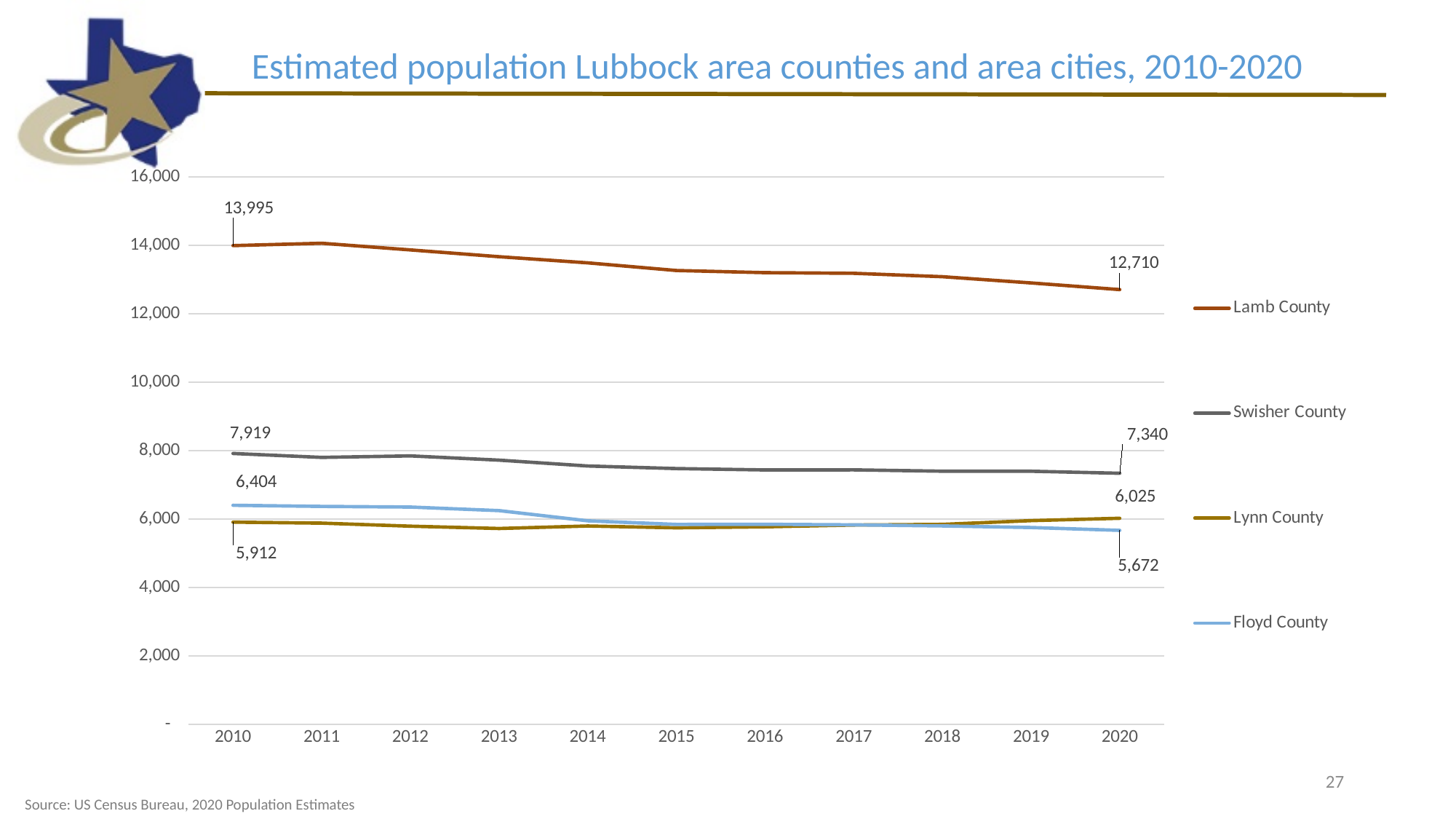
Did Lynn County's estimated population rise or fall between 2010 and 2020? rise What was the estimated population of Lynn County in 2020? 6,025 What was the estimated population of Lamb County in 2020? 12,710 Which county had the lowest estimated population in 2010? Lynn County Which county had a larger estimated population in 2020, Lynn County or Floyd County? Lynn County What was the estimated population of Swisher County in 2020? 7,340 How many series does the legend list? 4 What was the estimated population of Lamb County in 2010? 13,995 What was the estimated population of Floyd County in 2010? 6,404 Is the value for Swisher County in 2015 greater or less than 8,000? less Which county had the highest estimated population in 2020? Lamb County By how much did Lamb County's estimated population change from 2010 to 2020? 1,285